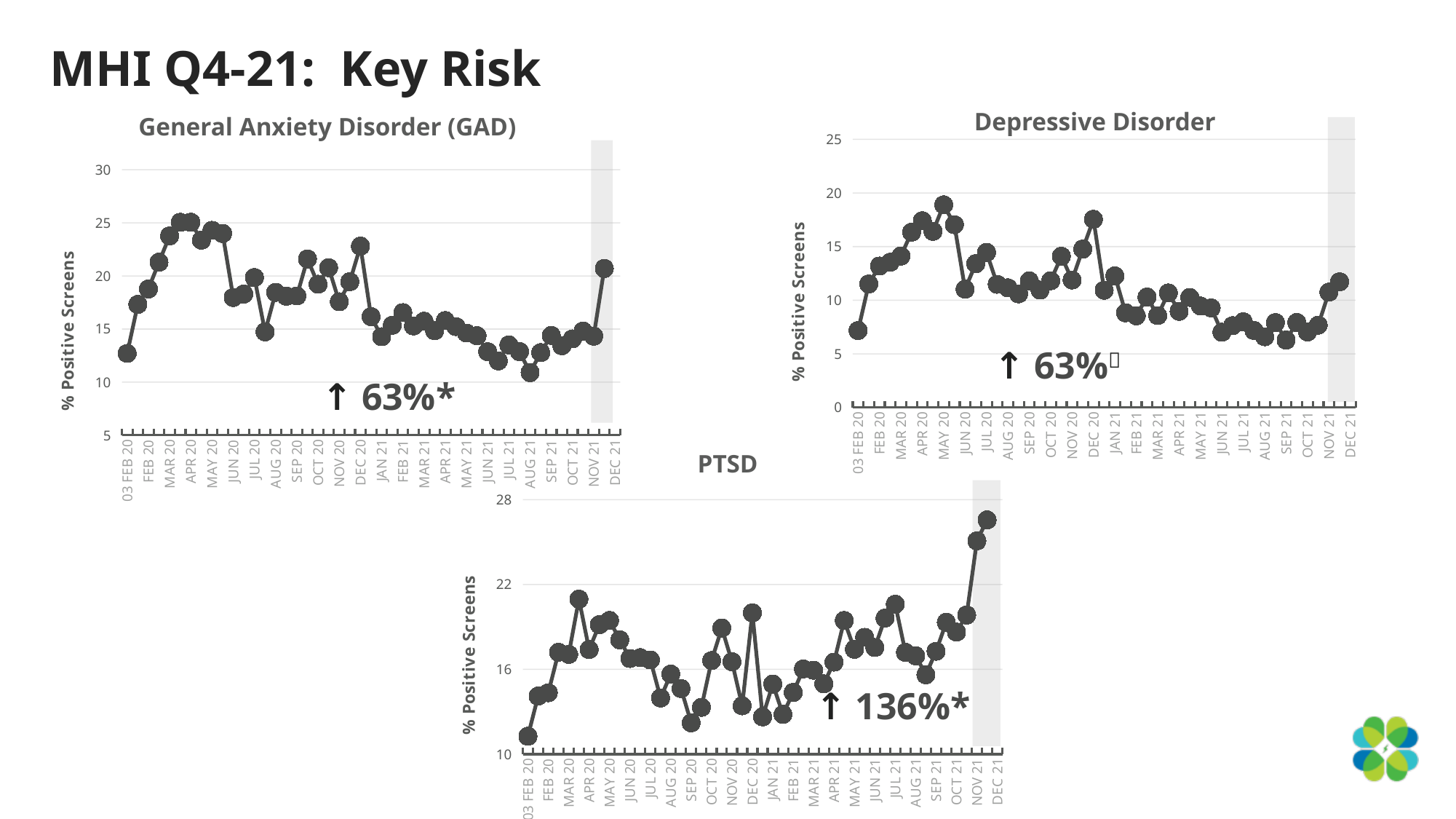
In the General Anxiety Disorder (GAD) chart, is the value for 03 FEB 20 greater or less than 15? less In the PTSD chart, what percentage increase is annotated on the chart? 136%* In the General Anxiety Disorder (GAD) chart, which month has the lowest value? AUG 21 What is the y-axis title of the PTSD chart? % Positive Screens What kind of chart is the General Anxiety Disorder (GAD) chart? Line chart In the PTSD chart, do the values rise or fall from OCT 21 to DEC 21? rise In the Depressive Disorder chart, which month has the highest value? MAY 20 In the Depressive Disorder chart, is the value for 03 FEB 20 greater or less than 10? less In the PTSD chart, is the value for DEC 21 greater or less than 22? greater In the PTSD chart, which month has the highest value? DEC 21 How many charts are shown on the slide? 3 In the Depressive Disorder chart, which is larger, the value for MAY 20 or the value for DEC 21? MAY 20